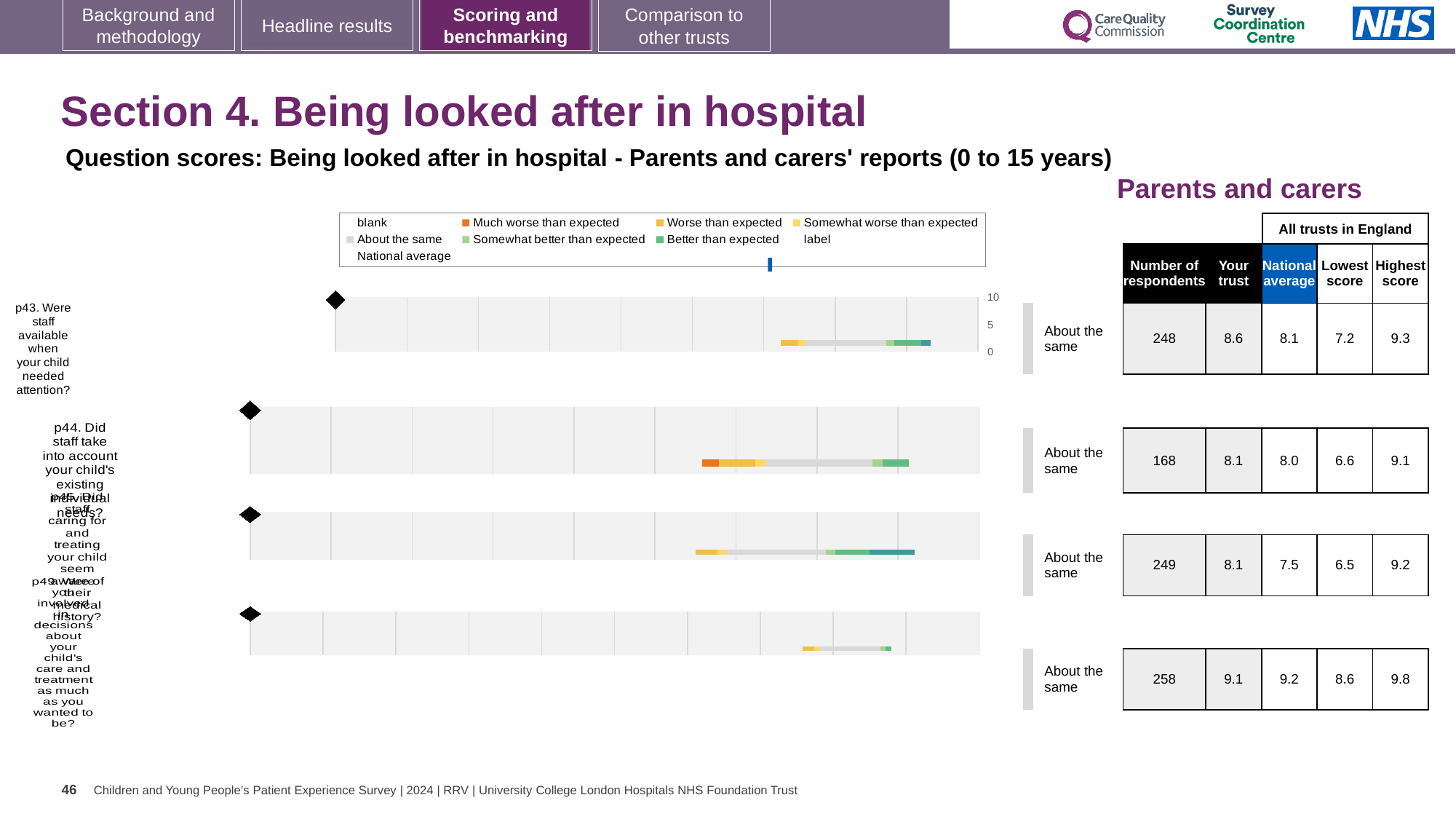
What kind of chart is used for each question row? Bar chart What is the lowest score across all trusts in England for the second question row (p44)? 6.6 How many question rows (charts) are shown on the slide? 4 What is the highest score across all trusts in England for the fourth (bottom) question row? 9.8 What benchmark category is shown for all four question rows? About the same For the fourth (bottom) question row, which is larger: the 'Your trust' score or the national average? National average For the third question row (p45), what is the difference between the 'Your trust' score and the national average? 0.6 What is the national average score shown for p43 (Were staff available when your child needed attention?)? 8.1 In the table next to the charts, what is the 'Your trust' score for p43 (Were staff available when your child needed attention?)? 8.6 Which question row has the lowest national average score? The third row (p45), 7.5 Which question row has the highest 'Your trust' score? The fourth (bottom) row, 9.1 How many respondents are listed for p43 (Were staff available when your child needed attention?)? 248